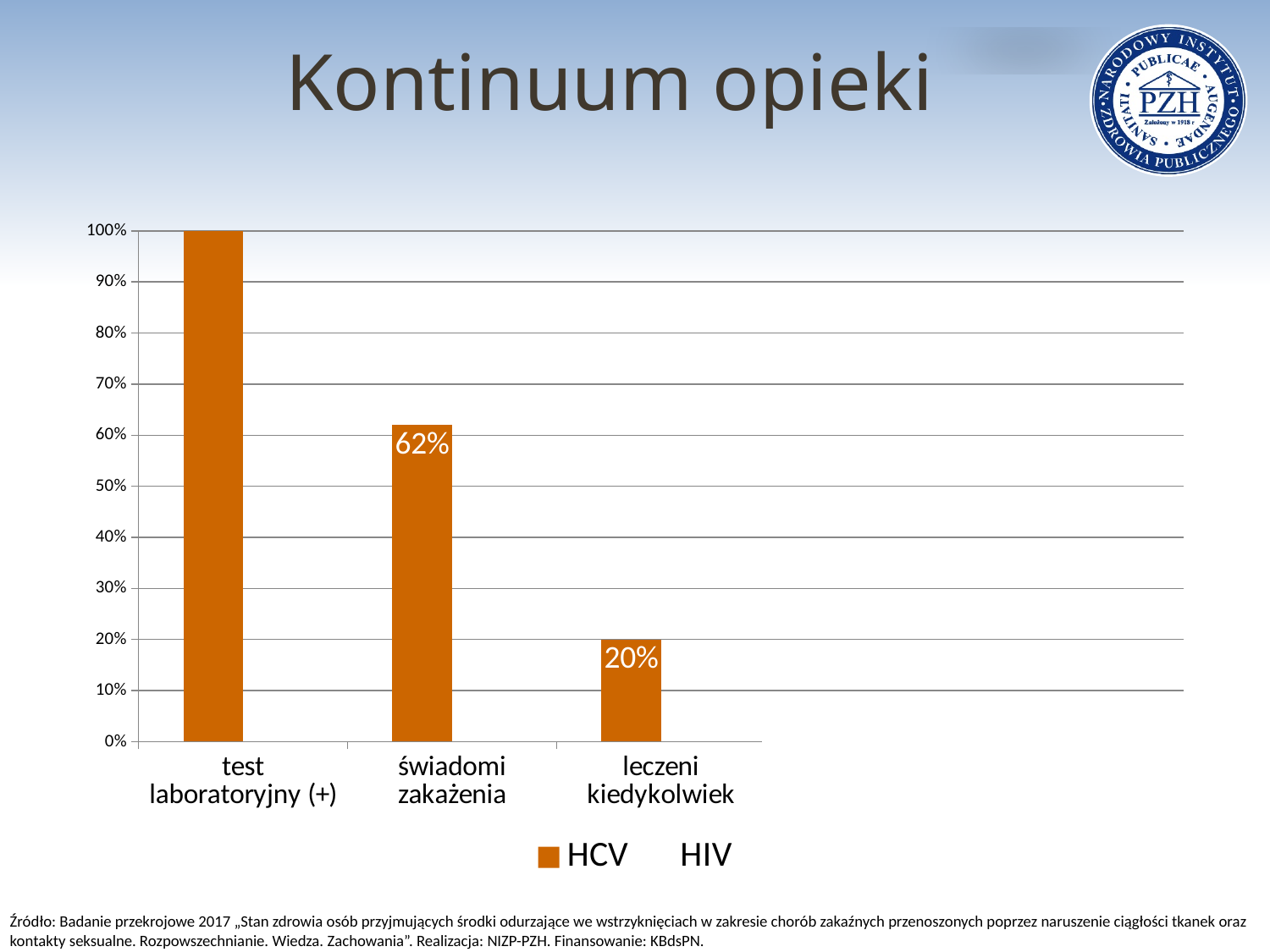
What is the difference between the values for "świadomi zakażenia" and "leczeni kiedykolwiek"? 42 percentage points Which category has the highest value? test laboratoryjny (+) Which is larger, the value for "świadomi zakażenia" or the value for "leczeni kiedykolwiek"? świadomi zakażenia Which category has the lowest value? leczeni kiedykolwiek Is the value for "świadomi zakażenia" greater or less than 50%? greater What is the value for "leczeni kiedykolwiek"? 20% What kind of chart is shown on the slide? bar chart What is the value for "test laboratoryjny (+)"? 100% What is the value for "świadomi zakażenia"? 62% How many series does the legend list? 2 Do the values rise or fall from left to right along the x axis? fall How many categories are shown on the x axis? 3